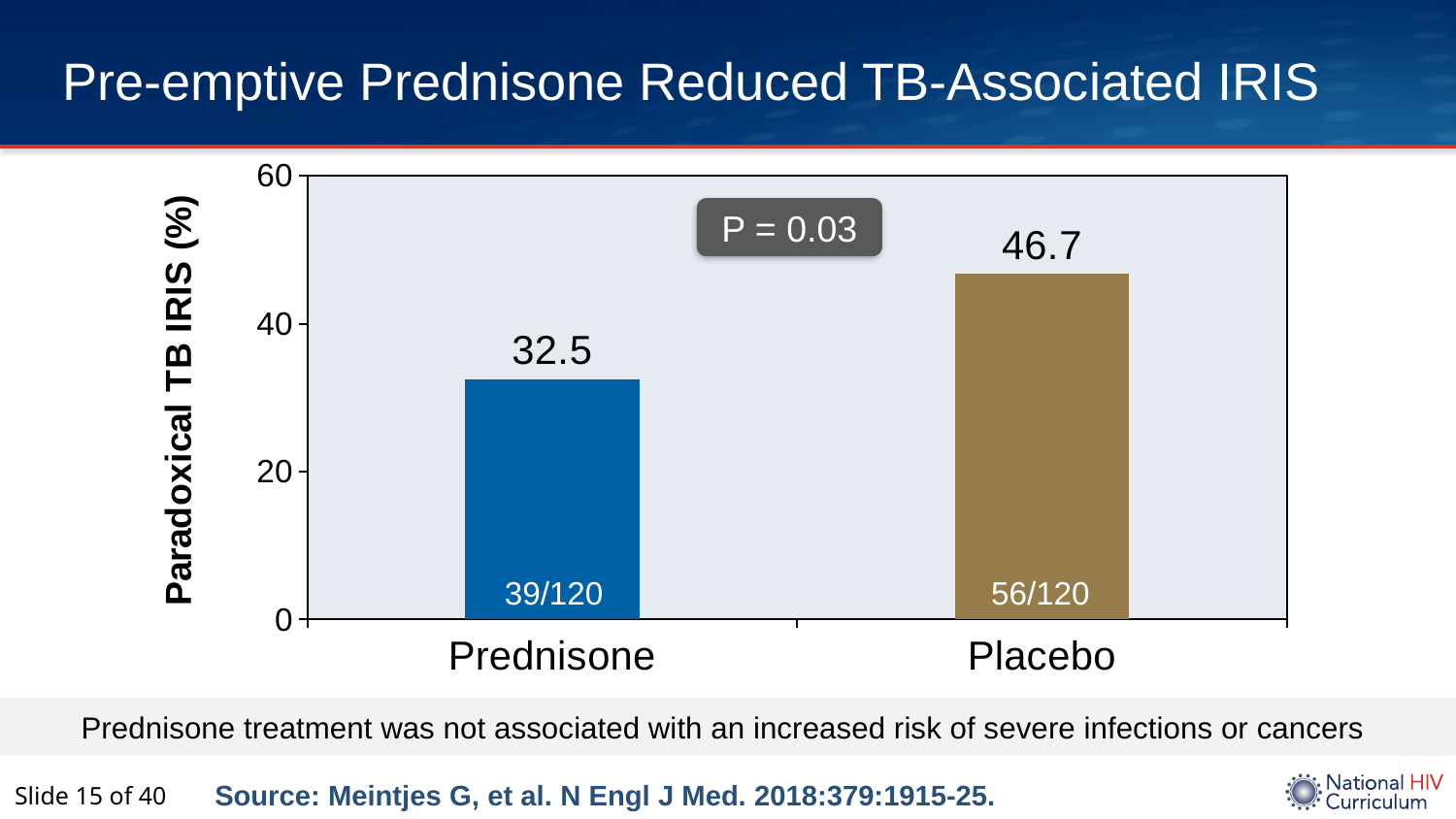
What is the value for Prednisone? 32.5 Is the value for Prednisone greater or less than 40? less What is the value for Placebo? 46.7 What P value is shown on the chart? P = 0.03 What is the label on the y axis? Paradoxical TB IRIS (%) Which category has the lowest value? Prednisone Which is larger, the value for Prednisone or the value for Placebo? Placebo Which category has the highest value? Placebo Is the value for Placebo greater or less than 40? greater What is the difference between the Placebo and Prednisone values? 14.2 How many categories are shown on the x axis? 2 What kind of chart is shown? bar chart